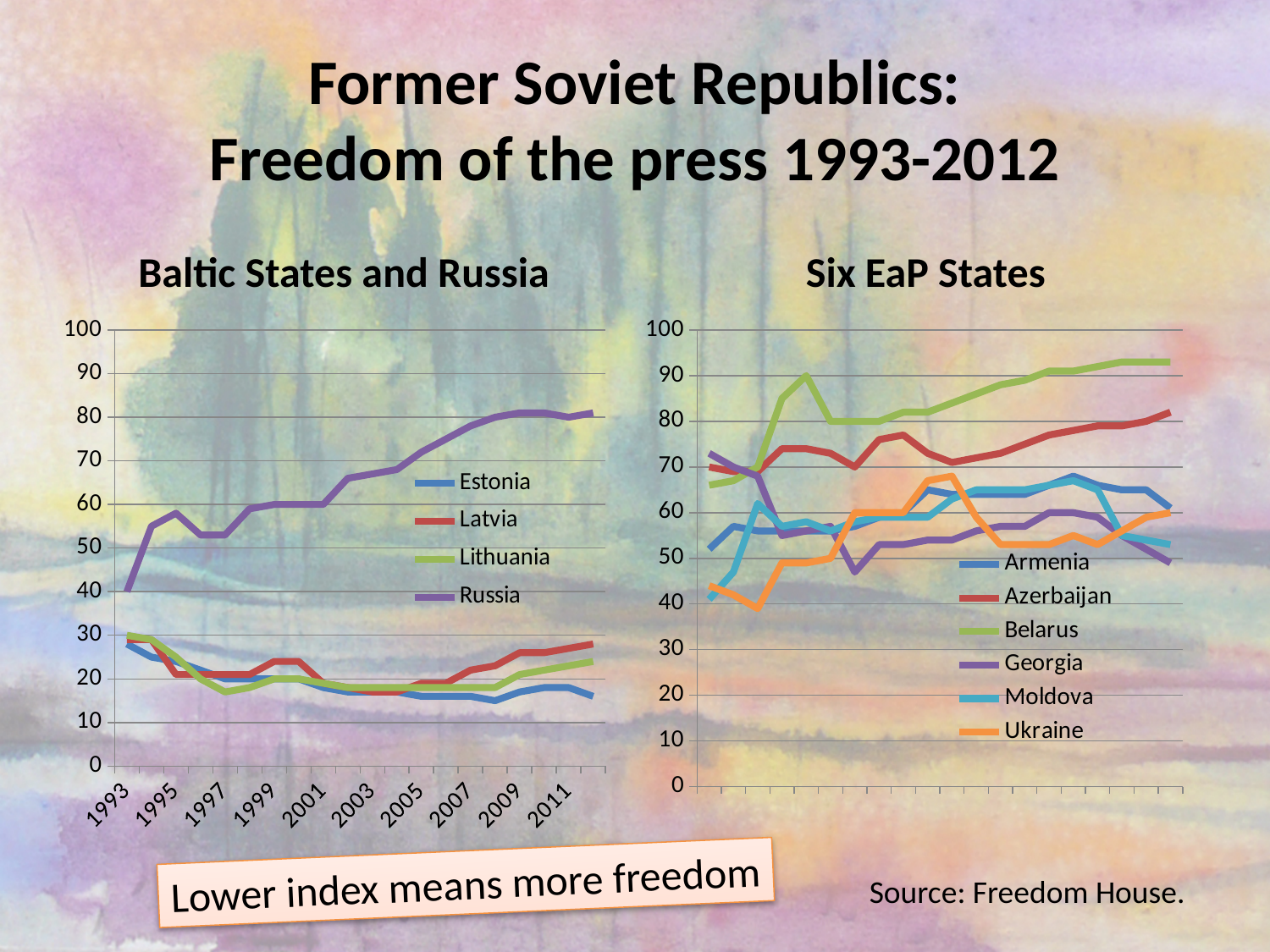
In the "Six EaP States" chart, is the value for Belarus at the right end of the chart greater or less than 80? greater How many series does the legend of the "Six EaP States" chart list? 6 What is the title of the chart on the right side of the slide? Six EaP States How many series does the legend of the "Baltic States and Russia" chart list? 4 In the "Baltic States and Russia" chart, is the value for Russia in 1993 greater or less than 50? less In the "Baltic States and Russia" chart, does the Russia line generally rise or fall from 1993 to 2011? rise What kind of chart is the "Baltic States and Russia" chart? line chart In the "Six EaP States" chart, which is larger at the right end of the chart, Belarus or Armenia? Belarus In the "Baltic States and Russia" chart, which country has the highest value in 2011? Russia In the "Baltic States and Russia" chart, is the value for Russia in 2011 greater or less than 70? greater In the "Six EaP States" chart, which country has the highest value at the right end of the chart? Belarus In the "Baltic States and Russia" chart, which country has the lowest value in 2011? Estonia